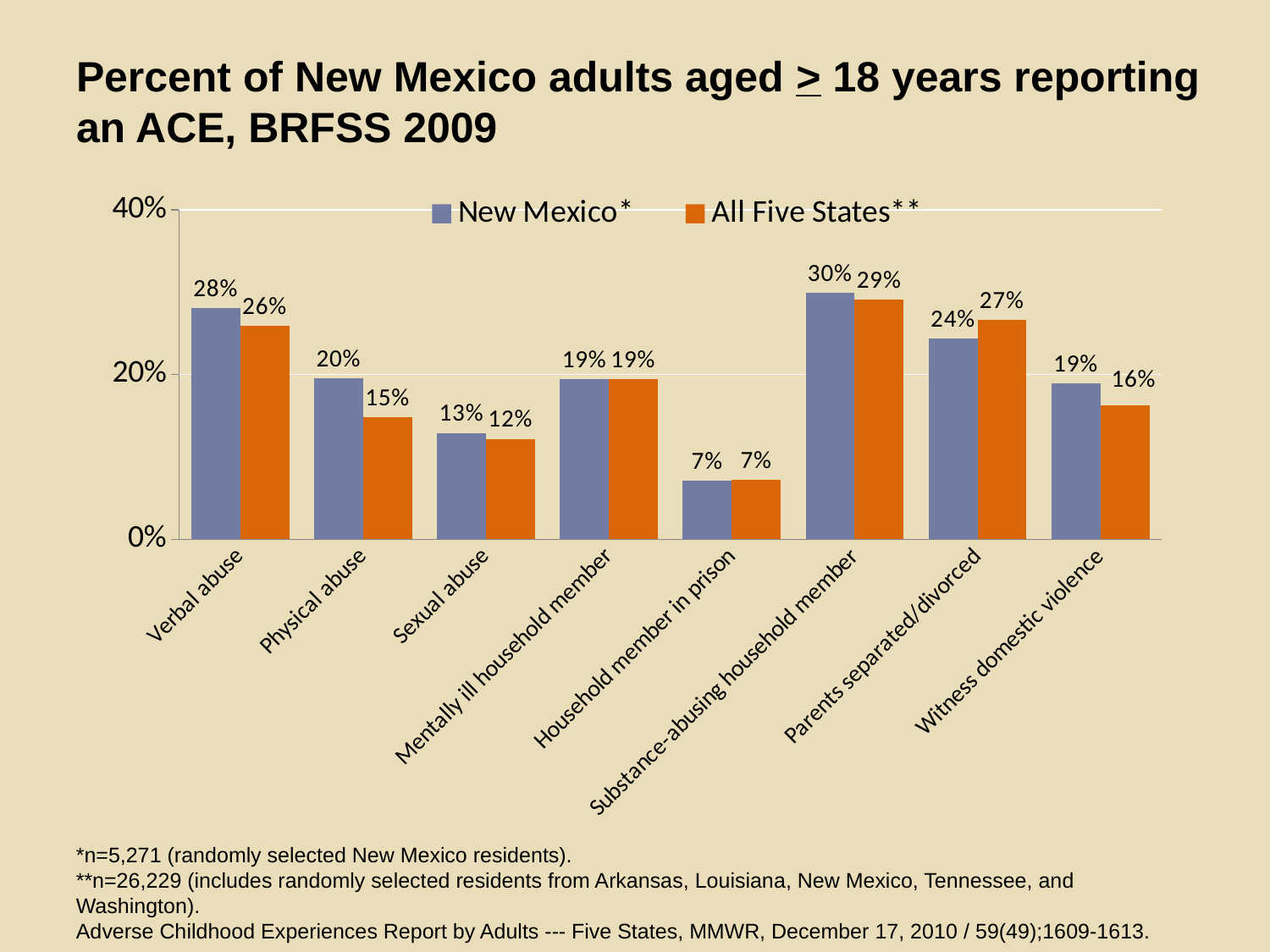
How many series does the legend list? 2 Which category has the highest New Mexico value? Substance-abusing household member What colour are the All Five States bars? orange Is the New Mexico value for Sexual abuse greater or less than 20%? less What is the difference between the New Mexico and All Five States values for Physical abuse? 5% Which category has the lowest All Five States value? Household member in prison What is the New Mexico value for Verbal abuse? 28% What is the All Five States value for Parents separated/divorced? 27% For Parents separated/divorced, which series has the larger value, New Mexico or All Five States? All Five States What is the New Mexico value for Witness domestic violence? 19% What kind of chart is shown on the slide? bar chart How many categories are shown on the x axis? 8